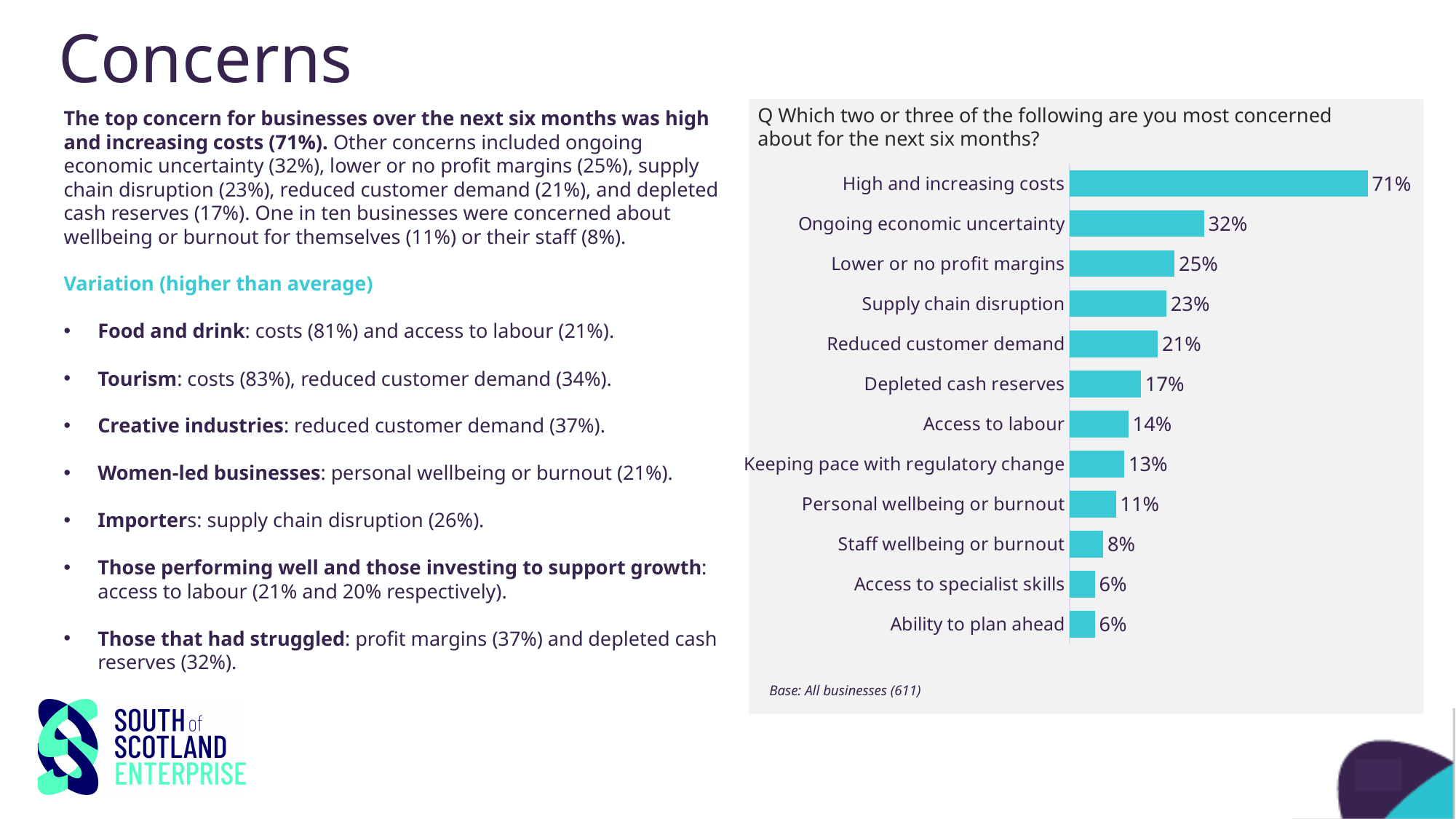
What percentage of businesses were most concerned about high and increasing costs? 71% What percentage is shown for Keeping pace with regulatory change? 13% What is the value shown for Supply chain disruption? 23% What is the difference between the values for Ongoing economic uncertainty and Lower or no profit margins? 7% Which two categories share the lowest value in the chart? Access to specialist skills and Ability to plan ahead What type of chart is used on the slide? Bar chart Which concern has the highest percentage in the chart? High and increasing costs How many concern categories are shown in the chart? 12 What is the difference between the values for High and increasing costs and Ongoing economic uncertainty? 39% Which has a larger value: Depleted cash reserves or Access to labour? Depleted cash reserves What is the base (number of respondents) stated below the chart? All businesses (611) What is the value shown for Staff wellbeing or burnout? 8%